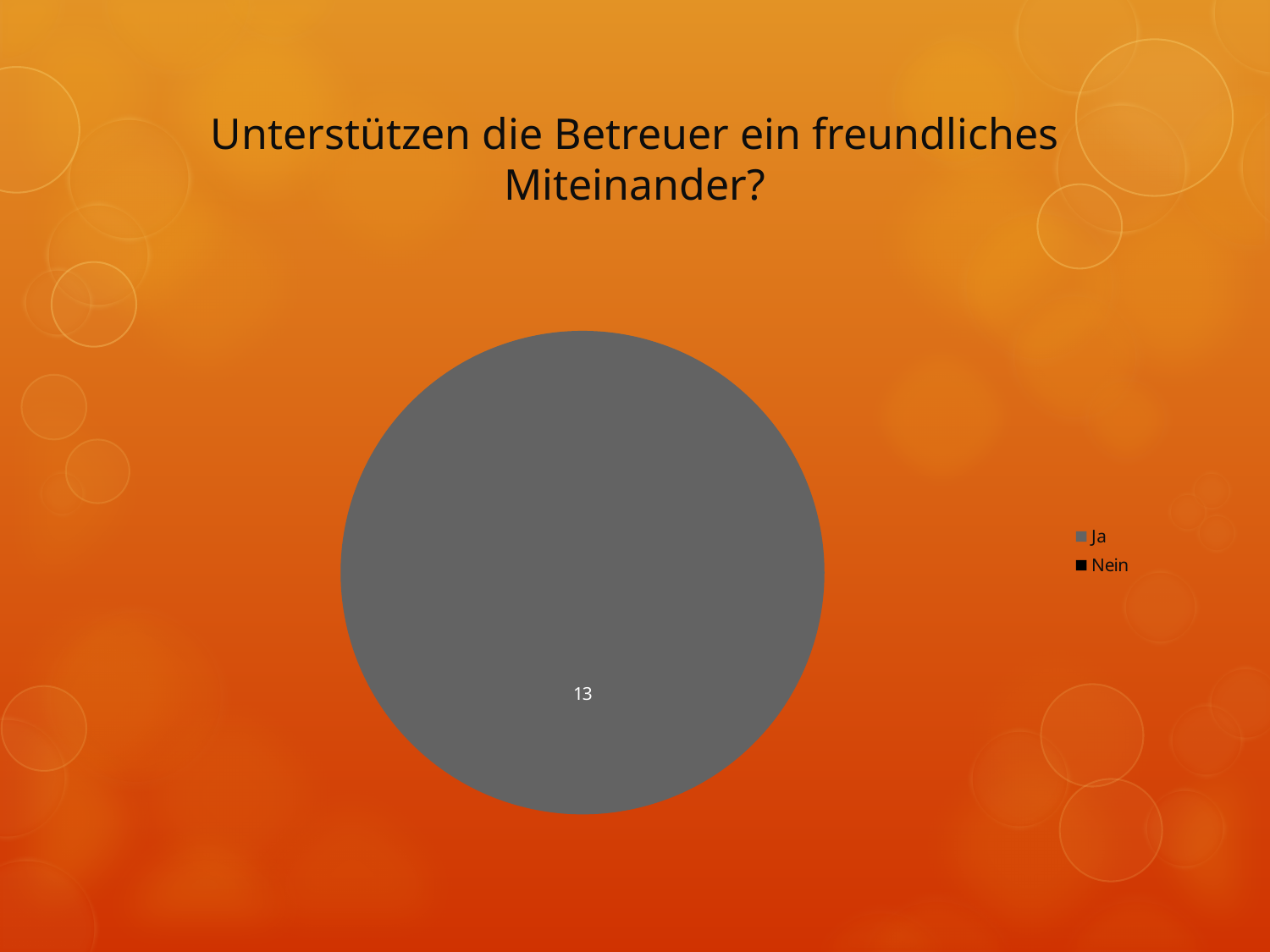
Which legend entry is shown with a gray marker? Ja What share of the pie does the Ja slice take up? 100% How many entries does the legend list? 2 What value is printed on the pie slice for Ja? 13 Which category has the largest slice of the pie? Ja Which of the two categories, Ja or Nein, has the larger value? Ja What is the title of the chart? Unterstützen die Betreuer ein freundliches Miteinander? What kind of chart is shown on the slide? pie chart